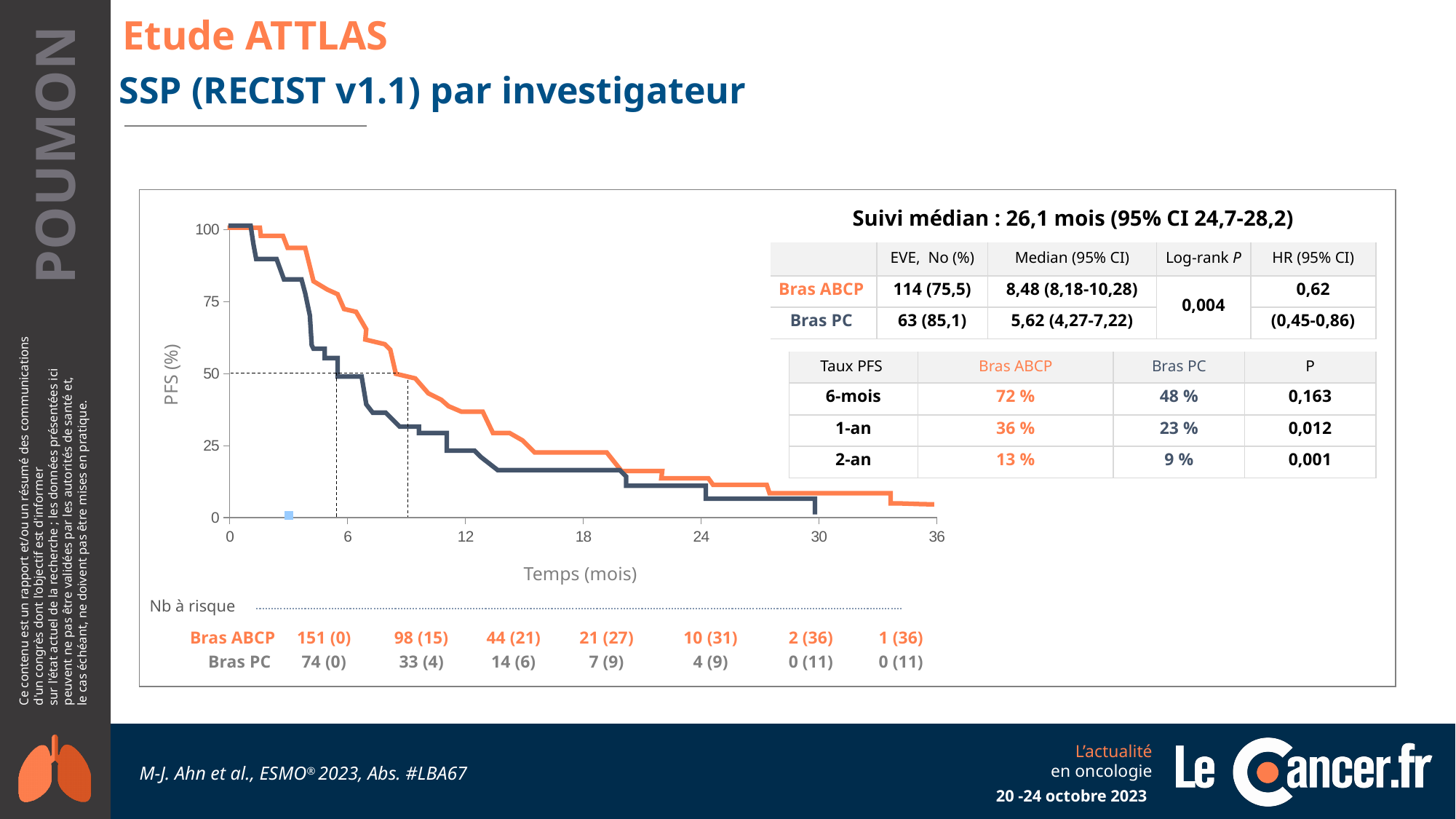
Which arm has the higher PFS rate at 1 year, Bras ABCP or Bras PC? Bras ABCP What kind of chart is shown on the slide? Line chart (Kaplan-Meier survival curve) How many patients were at risk at time 0 in Bras ABCP? 151 What is the label of the y axis of the chart? PFS (%) What is the median PFS (95% CI) for Bras PC? 5,62 (4,27-7,22) What is the difference in PFS rate at 6 months between Bras ABCP and Bras PC? 24 percentage points What is the label of the x axis of the chart? Temps (mois) What is the PFS rate at 6 months for Bras ABCP? 72 % What is the PFS rate at 2 years for Bras PC? 9 % How many treatment arms (series) are plotted on the chart? 2 What is the median PFS (95% CI) for Bras ABCP? 8,48 (8,18-10,28) Do the PFS curves rise or fall as time (months) increases? Fall